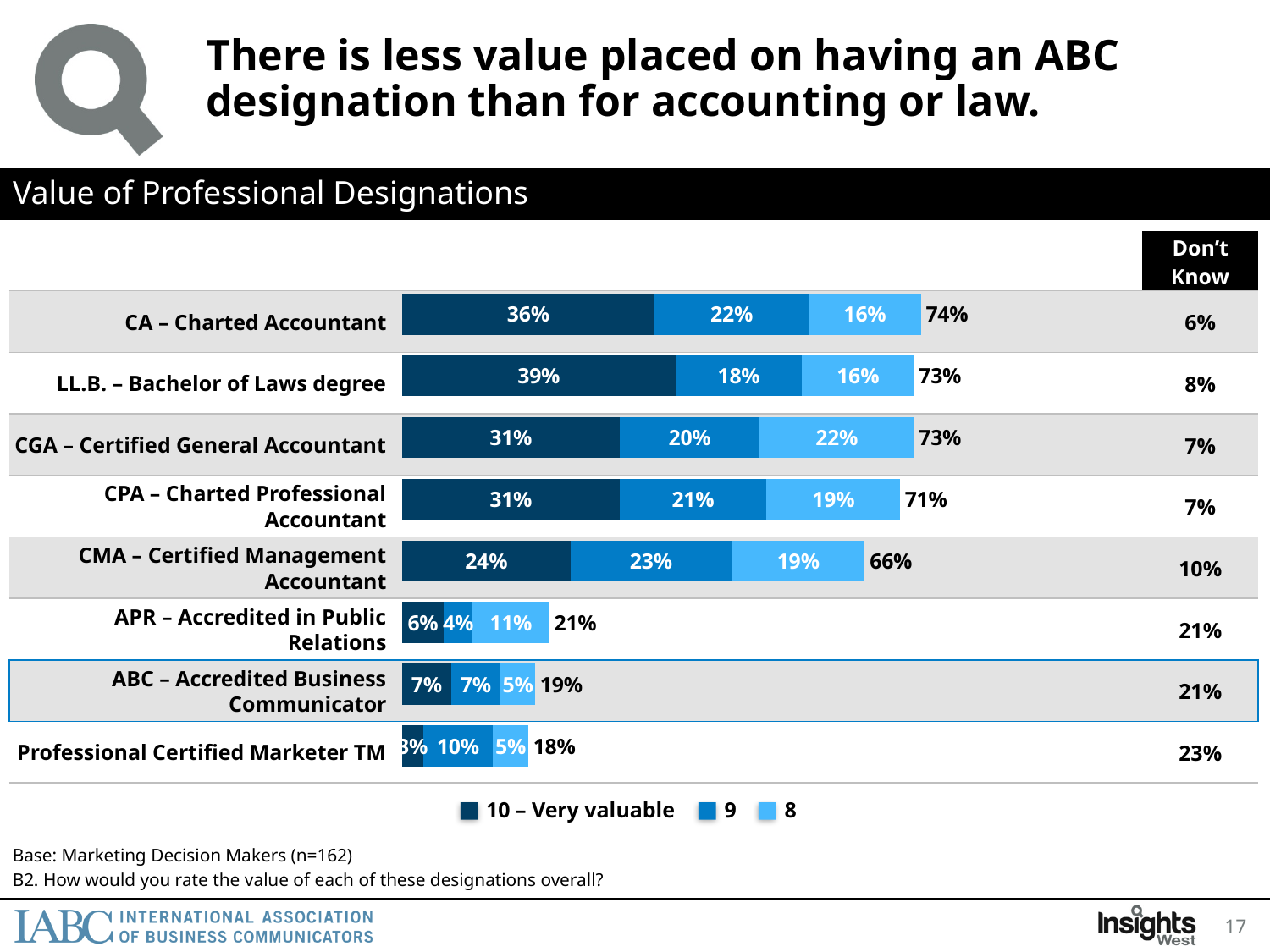
What type of chart is used to show the value of professional designations? Stacked bar chart What is the sum of the 10, 9 and 8 ratings for the APR – Accredited in Public Relations designation (6% + 4% + 11%)? 21% How many designations are listed in the chart? 8 Which has a higher 10 – Very valuable percentage: LL.B. – Bachelor of Laws degree or CGA – Certified General Accountant? LL.B. – Bachelor of Laws degree What is the combined (8–10) total shown for the LL.B. – Bachelor of Laws degree? 73% What is the title of the chart? Value of Professional Designations How many series does the legend list? 3 What is the difference between the combined totals for the CA – Charted Accountant (74%) and the ABC – Accredited Business Communicator (19%)? 55% Which designation has the lowest combined total shown at the end of its bar? Professional Certified Marketer TM What percentage of respondents rated the CA – Charted Accountant designation as 10 – Very valuable? 36% Which designation has the highest combined total shown at the end of its bar? CA – Charted Accountant What is the Don't Know percentage for the CMA – Certified Management Accountant? 10%